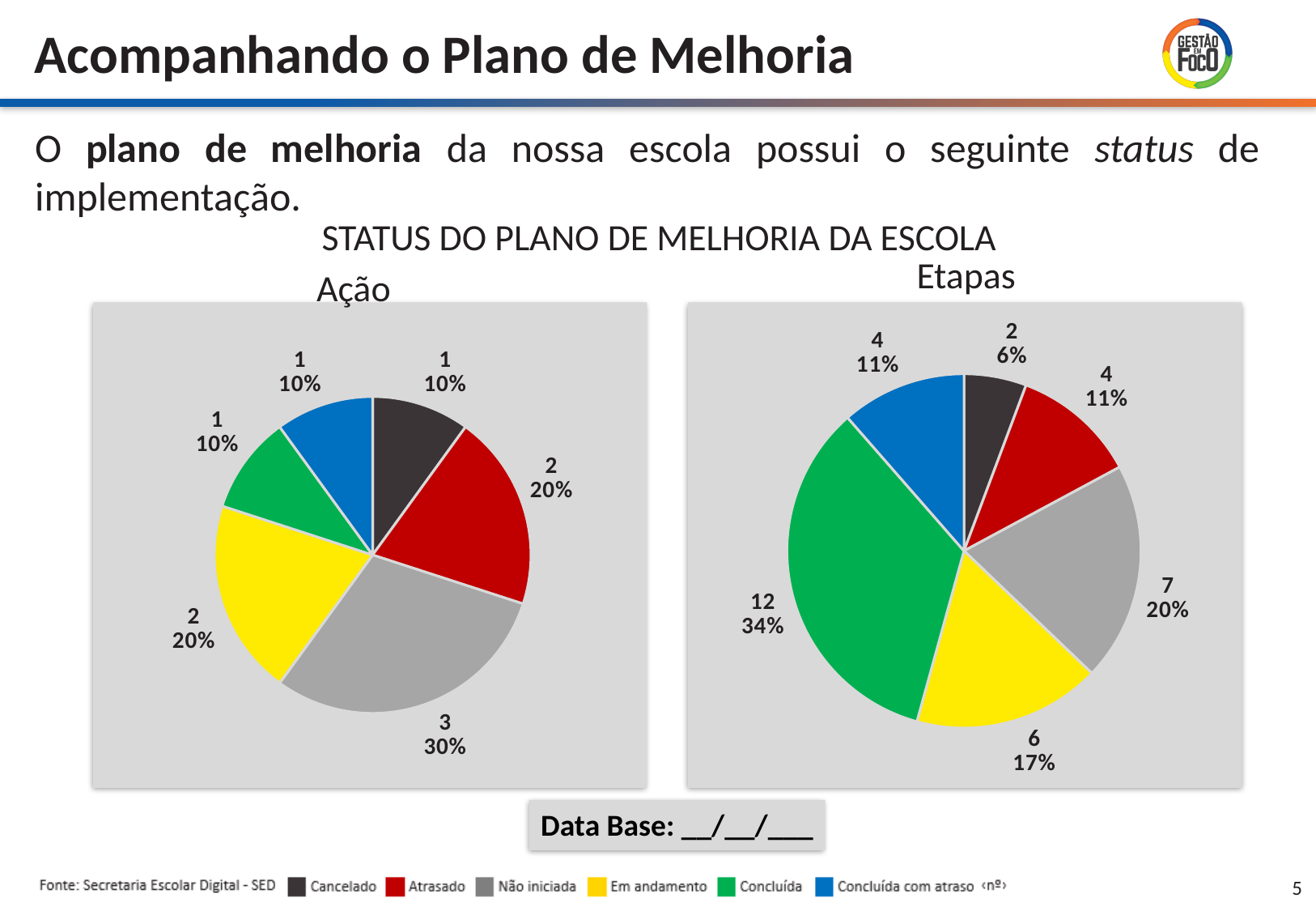
In the "Etapas" pie chart, what share of the pie is Em andamento? 17% In the "Etapas" pie chart, what is the difference between the values for Concluída and Não iniciada? 5 What colour represents Concluída com atraso in the legend? Blue In the "Ação" pie chart, what share of the pie is Atrasado? 20% How many entries does the legend at the bottom of the slide list? 6 In the "Etapas" pie chart, what is the value for Concluída? 12 What type of chart is the "Etapas" chart? Pie chart In the "Etapas" pie chart, which is larger, Atrasado or Em andamento? Em andamento In the "Etapas" pie chart, which category has the smallest slice? Cancelado How many slices does the "Ação" pie chart have? 6 In the "Ação" pie chart, which category has the largest slice? Não iniciada In the "Ação" pie chart, what is the value for Não iniciada? 3